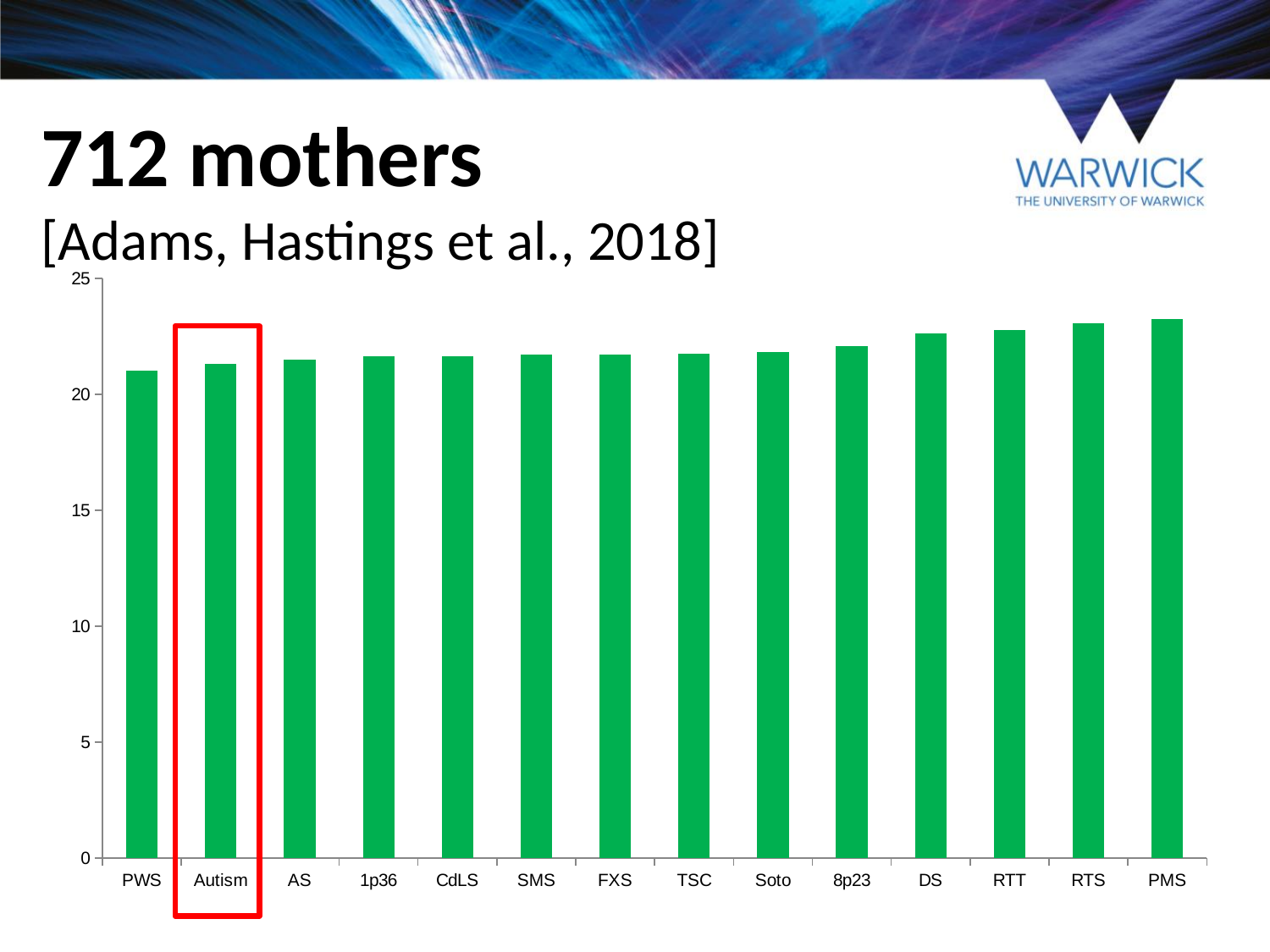
Do the bar values generally rise or fall from left to right along the x axis? rise Is the value for PMS greater or less than 25? less What colour are the bars in the chart? green Which is larger, the value for PMS or the value for PWS? PMS How many categories are shown on the x axis of the chart? 14 Is the value for Autism greater or less than 20? greater Is the value for PWS greater or less than 20? greater Which category has the highest bar in the chart? PMS Which category is highlighted with a red box on the chart? Autism Which category has the lowest bar in the chart? PWS Which is larger, the value for Autism or the value for RTS? RTS What kind of chart is shown on the slide? bar chart